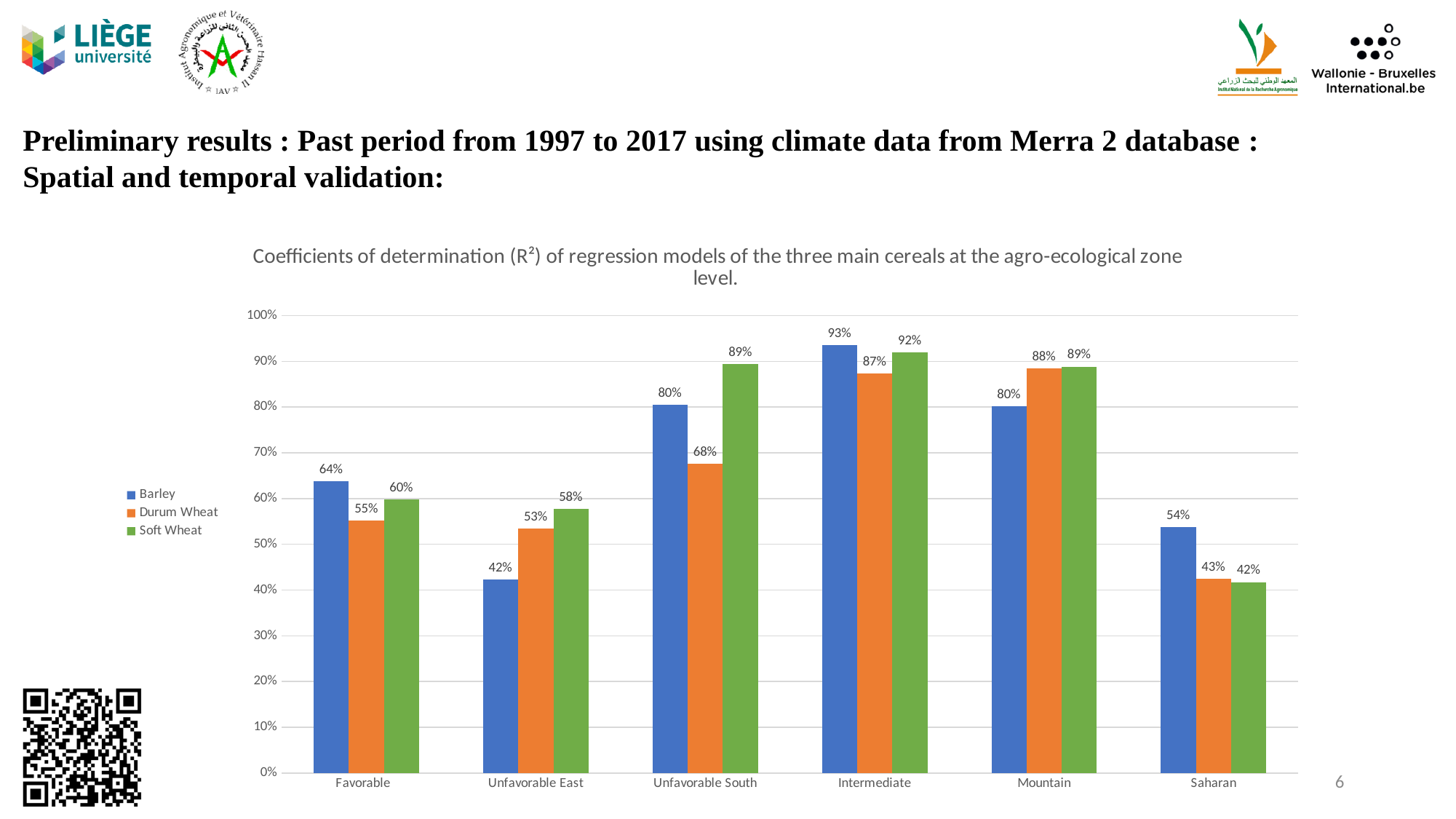
How many agro-ecological zones are shown on the x axis? 6 What is the difference between the Soft Wheat and Durum Wheat values for Unfavorable South? 21% Which series is shown in orange in the legend? Durum Wheat Which zone has the highest Barley value? Intermediate What is the Durum Wheat value for Unfavorable South? 68% How many series does the legend list? 3 What kind of chart is shown on the slide? Bar chart Is the Durum Wheat value for Mountain greater or less than 80%? greater Which is larger for the Favorable zone, Barley or Soft Wheat? Barley What is the Barley value for the Intermediate zone? 93% Which zone has the lowest Soft Wheat value? Saharan What is the Soft Wheat value for Saharan? 42%